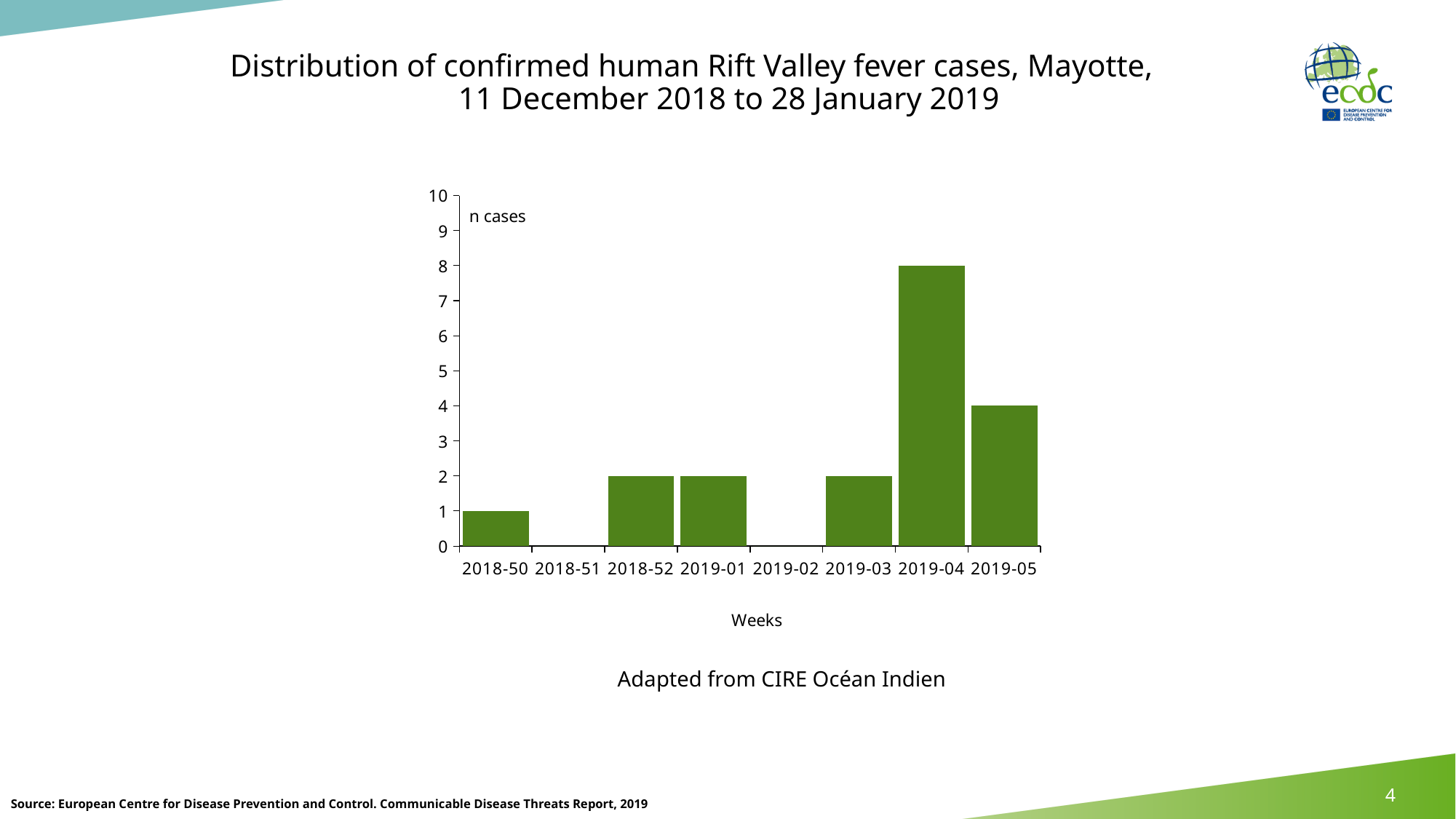
Which week has the highest number of cases? 2019-04 How many cases are shown for week 2019-05? 4 How many cases are shown for week 2018-52? 2 How many cases are shown for week 2018-50? 1 How many cases are shown for week 2019-04? 8 How many cases are shown for week 2019-02? 0 What is the label of the x axis? Weeks Is the value for week 2019-04 greater or less than 5? greater What is the difference in cases between week 2019-04 and week 2019-05? 4 What type of chart is shown on the slide? bar chart Which week has more cases, 2019-03 or 2019-05? 2019-05 How many weeks are shown on the x axis of the chart? 8